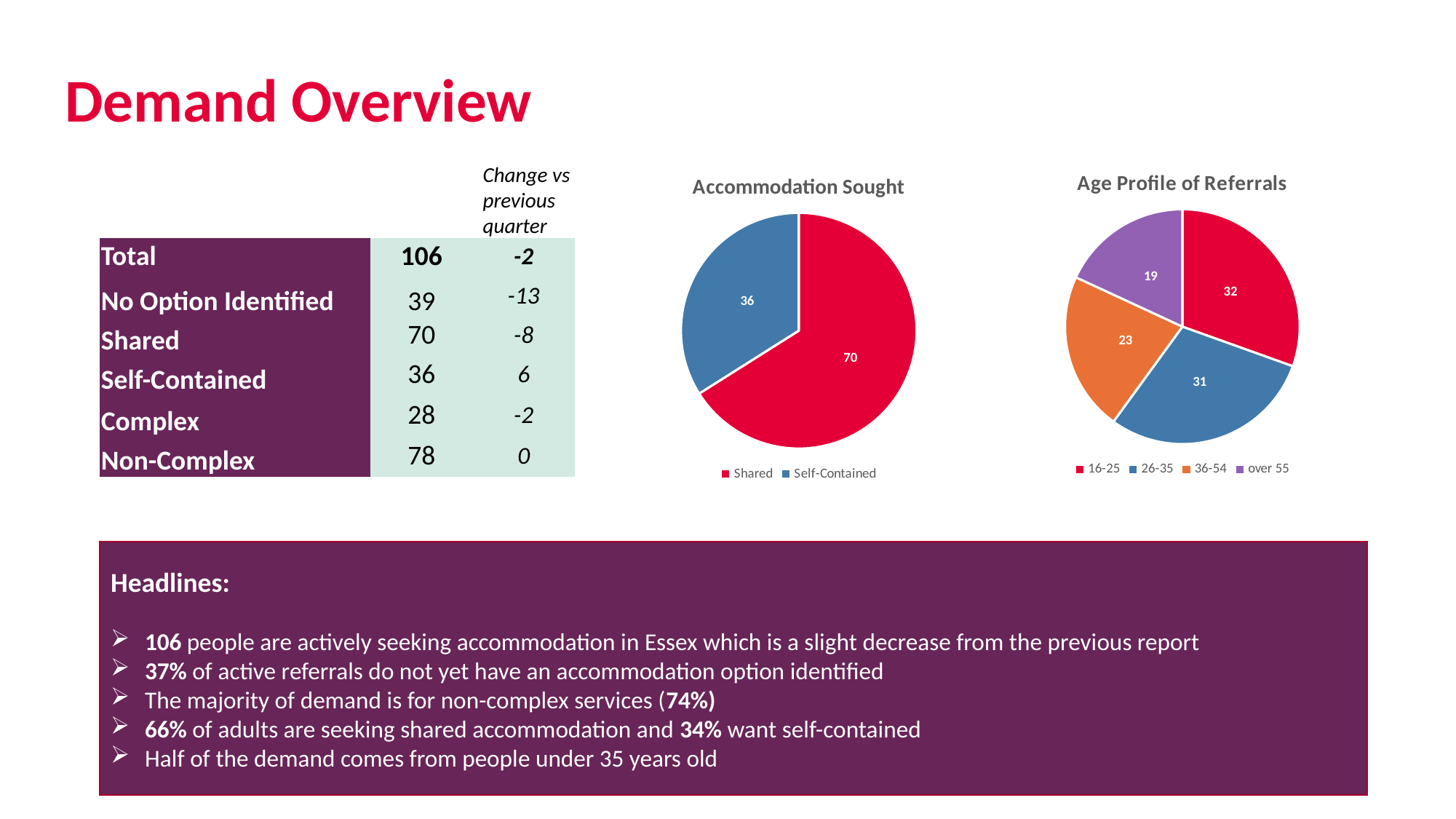
In the Age Profile of Referrals chart, what is the difference between the 26-35 and 36-54 values? 8 What kind of chart is the Accommodation Sought chart? Pie chart In the Age Profile of Referrals chart, which age group has the lowest value? over 55 In the Age Profile of Referrals chart, which age group has the highest value? 16-25 In the Accommodation Sought chart, what share of the pie does Shared represent? 66% How many age groups are shown in the Age Profile of Referrals chart? 4 In the Accommodation Sought chart, what is the value for Self-Contained? 36 In the Accommodation Sought chart, what is the value for Shared? 70 In the Accommodation Sought chart, which category is larger, Shared or Self-Contained? Shared In the Age Profile of Referrals chart, what is the value for the over 55 age group? 19 In the Age Profile of Referrals chart, what is the value for the 36-54 age group? 23 In the Accommodation Sought chart, what is the difference between the Shared and Self-Contained values? 34